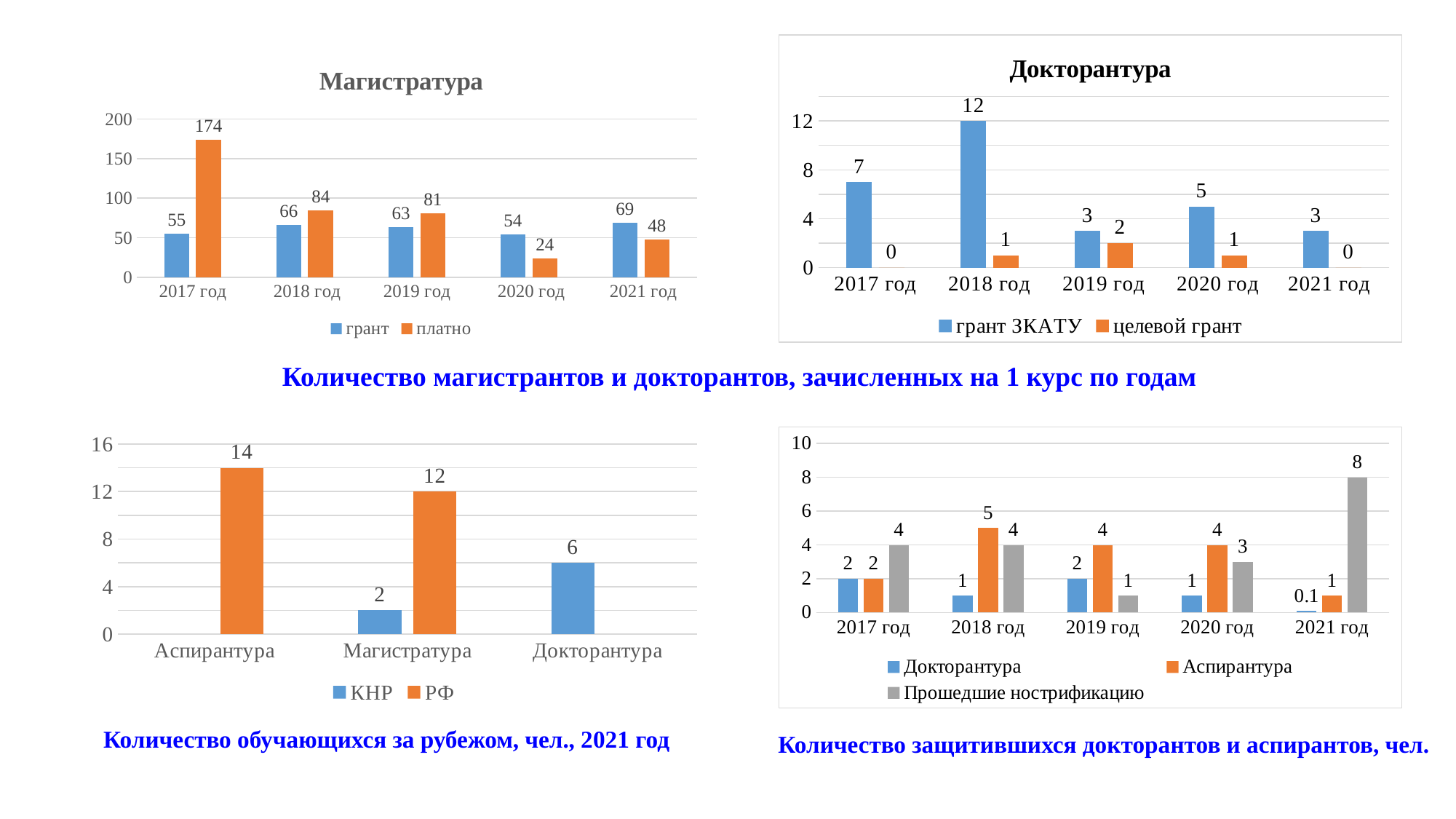
In the 'Магистратура' chart, which year has the highest value for 'грант'? 2021 год In the 'Количество защитившихся докторантов и аспирантов, чел.' chart, which year has the highest value for 'Аспирантура'? 2018 год In the 'Докторантура' chart, how many series does the legend list? 2 In the 'Докторантура' chart, what is the value for 'грант ЗКАТУ' in 2018 год? 12 In the 'Количество обучающихся за рубежом, чел., 2021 год' chart, what is the value for 'РФ' in Аспирантура? 14 What kind of chart is the 'Магистратура' chart? bar chart In the 'Магистратура' chart, what is the value for 'платно' in 2017 год? 174 In the 'Количество защитившихся докторантов и аспирантов, чел.' chart, what is the value for 'Прошедшие нострификацию' in 2021 год? 8 In the 'Количество обучающихся за рубежом, чел., 2021 год' chart, how many categories are shown on the x axis? 3 In the 'Магистратура' chart, what is the difference between 'платно' and 'грант' in 2018 год? 18 In the 'Докторантура' chart, which year has the lowest value for 'грант ЗКАТУ'? 2019 год and 2021 год In the 'Магистратура' chart, which is larger in 2020 год: 'грант' or 'платно'? грант